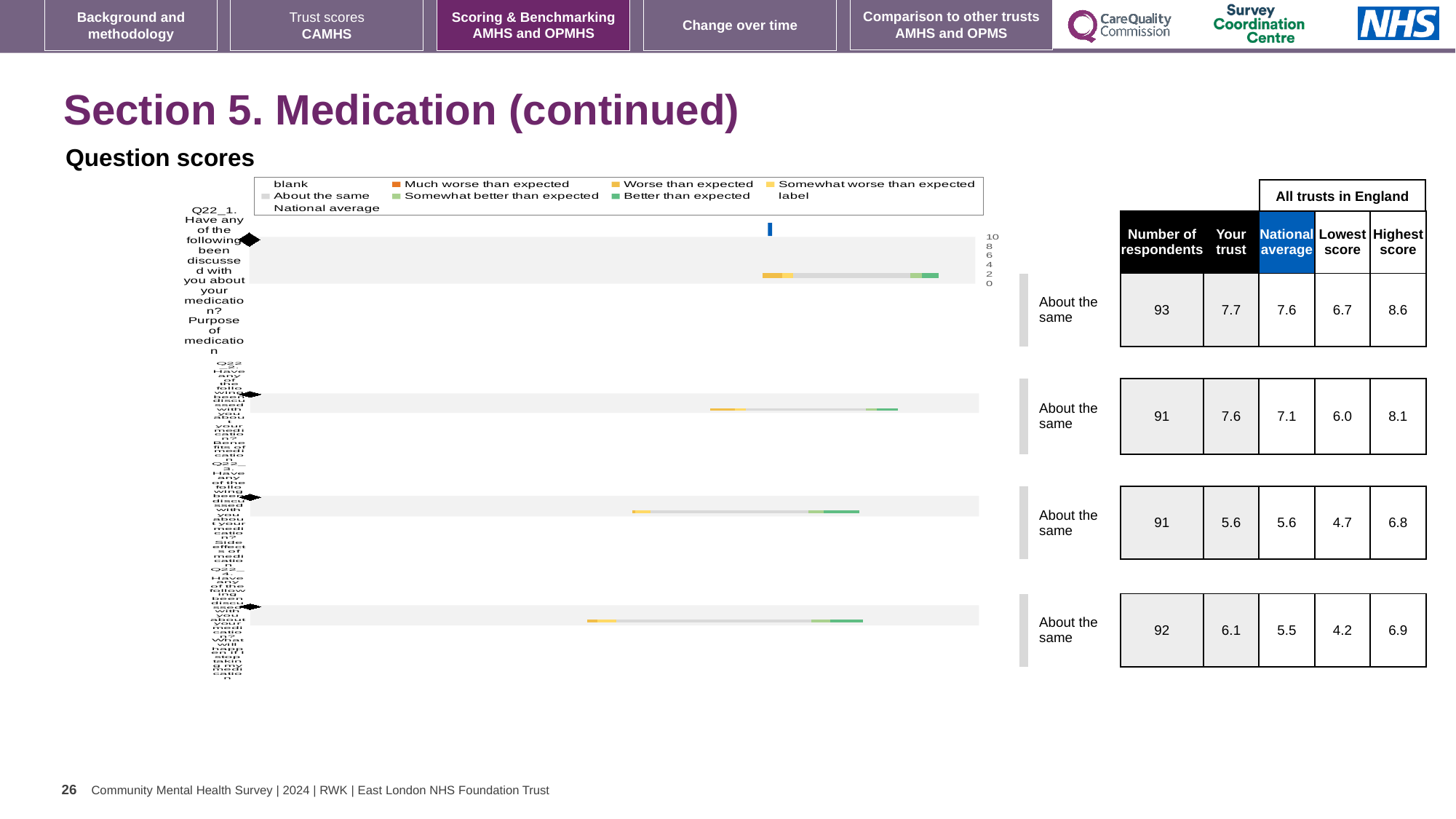
In the chart legend, which entry is shown in orange? Much worse than expected How many respondents are recorded for the first question row (Q22_1)? 93 For the fourth question row (Q22_4), which is larger: the 'Your trust' score or the national average? Your trust What is the national average score for Q22_1 (Purpose of medication)? 7.6 What kind of chart is used to show the question scores on this slide? bar chart What is the 'Your trust' score for Q22_1 (Purpose of medication)? 7.7 What is the difference between the highest score and the lowest score for Q22_1 (Purpose of medication)? 1.9 Which question row has the highest 'Your trust' score? Q22_1 (Purpose of medication) Which question row has the lowest 'Your trust' score? Q22_3 (Side effects of medication) How many question rows (bars) are plotted in the question scores chart? 4 In the chart legend, which entry is shown in dark green? Better than expected What benchmark label is shown next to each of the four question rows? About the same